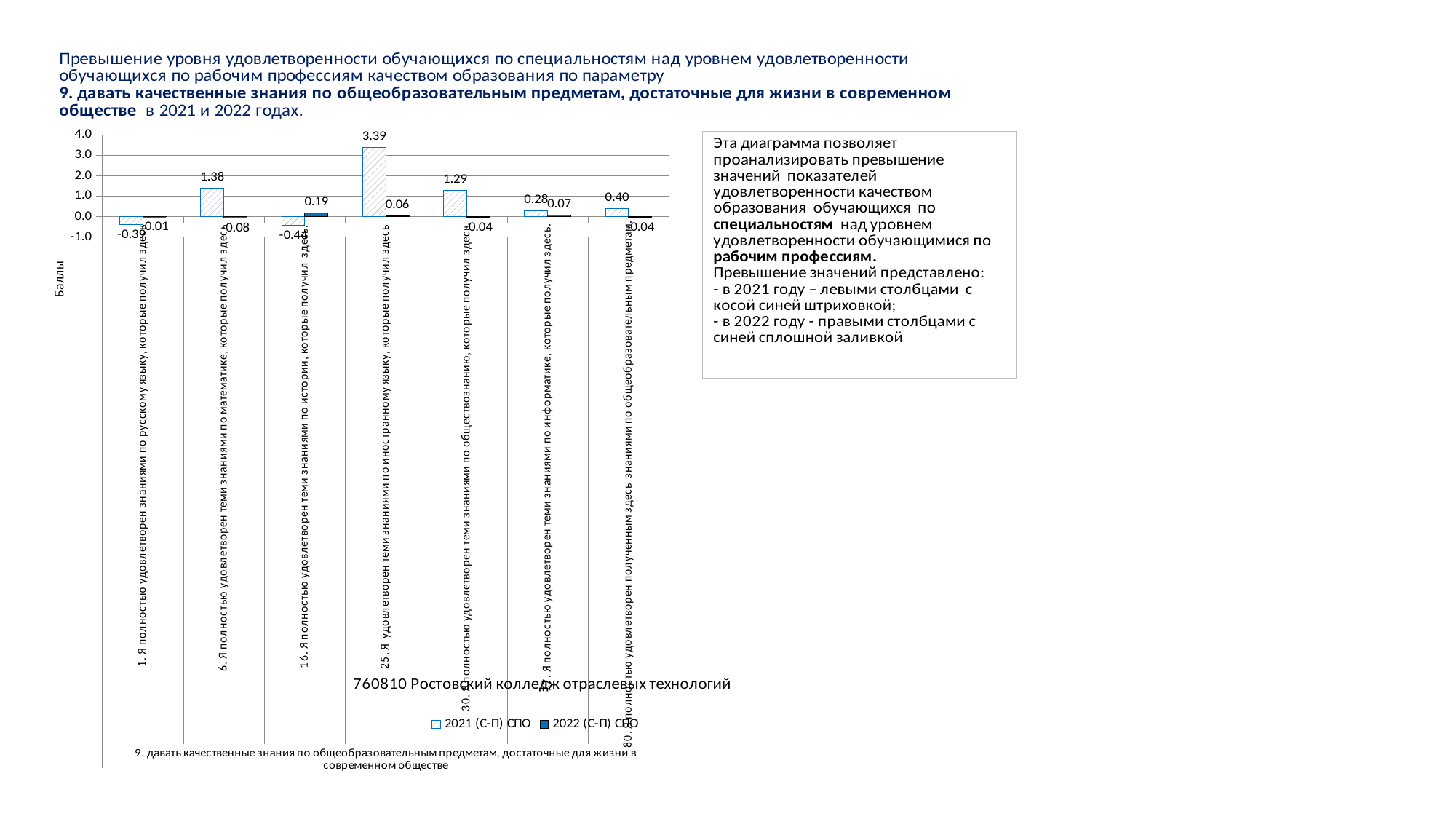
What is the 2022 (С-П) СПО value for the statement about knowledge of history (16)? 0.19 What is the label of the vertical axis? Баллы How many categories (statements) are plotted on the x axis? 7 For the informatics statement, which series has the larger value: 2021 (С-П) СПО or 2022 (С-П) СПО? 2021 (С-П) СПО What is the 2021 (С-П) СПО value for the statement about knowledge of foreign language (25)? 3.39 What kind of chart is shown on the slide? bar chart Which statement has the highest 2021 (С-П) СПО value? 25. Я удовлетворен теми знаниями по иностранному языку, которые получил здесь What is the 2021 (С-П) СПО value for the statement about knowledge of mathematics (6)? 1.38 What is the 2021 (С-П) СПО value for the statement about knowledge of Russian language (1)? -0.39 Which statement has the lowest 2021 (С-П) СПО value? 16. Я полностью удовлетворен теми знаниями по истории, которые получил здесь What is the difference between the 2021 (С-П) СПО values for the foreign language statement (25) and the social studies statement (30)? 2.10 How many series does the legend list? 2